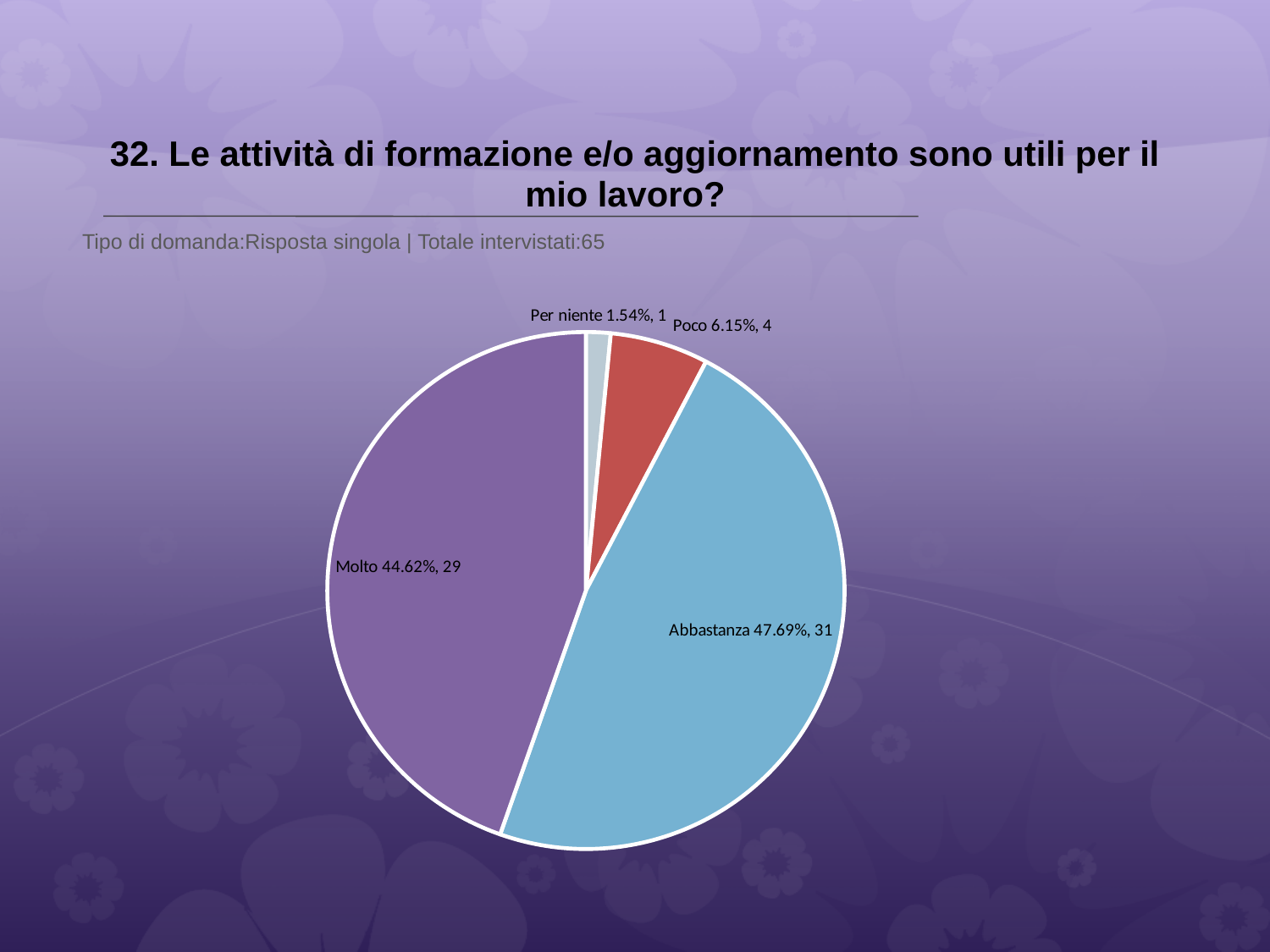
What is the difference in respondent count between 'Abbastanza' and 'Molto'? 2 What kind of chart is shown on the slide? pie chart How many respondents answered 'Poco'? 4 Which has more respondents, 'Poco' or 'Per niente'? Poco What percentage share does the 'Molto' slice have? 44.62% Which category has the largest slice? Abbastanza What percentage share does the 'Abbastanza' slice have? 47.69% How many slices does the pie chart have? 4 How many respondents answered 'Molto'? 29 What is the total number of respondents stated on the slide? 65 Which category has the smallest slice? Per niente How many respondents answered 'Per niente'? 1